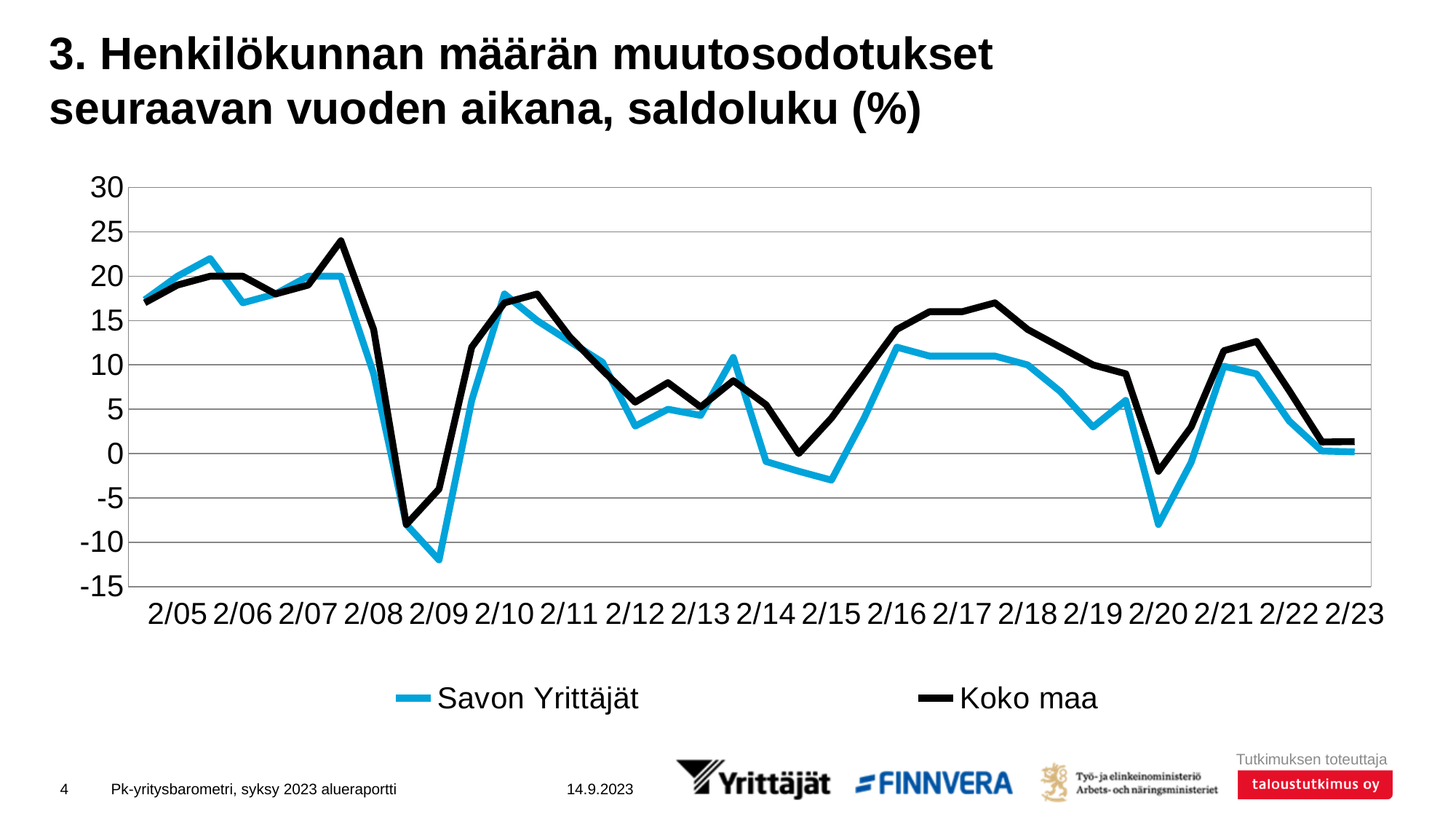
Is the value for Savon Yrittäjät at 2/20 greater or less than -5? less At 2/19, which series has the higher value, Savon Yrittäjät or Koko maa? Koko maa What kind of chart is shown on the slide? line chart Which series reaches the highest value anywhere on the chart? Koko maa What colour is the line for Savon Yrittäjät? blue Which series reaches the lowest value anywhere on the chart? Savon Yrittäjät At 2/20, which series has the higher value, Savon Yrittäjät or Koko maa? Koko maa How many year labels are shown on the x axis? 19 Is the value for Koko maa at 2/23 greater or less than 5? less Do the values for Koko maa rise or fall from 2/21 to 2/23? fall How many series does the legend list? 2 Is the value for Koko maa at 2/16 greater or less than 10? greater